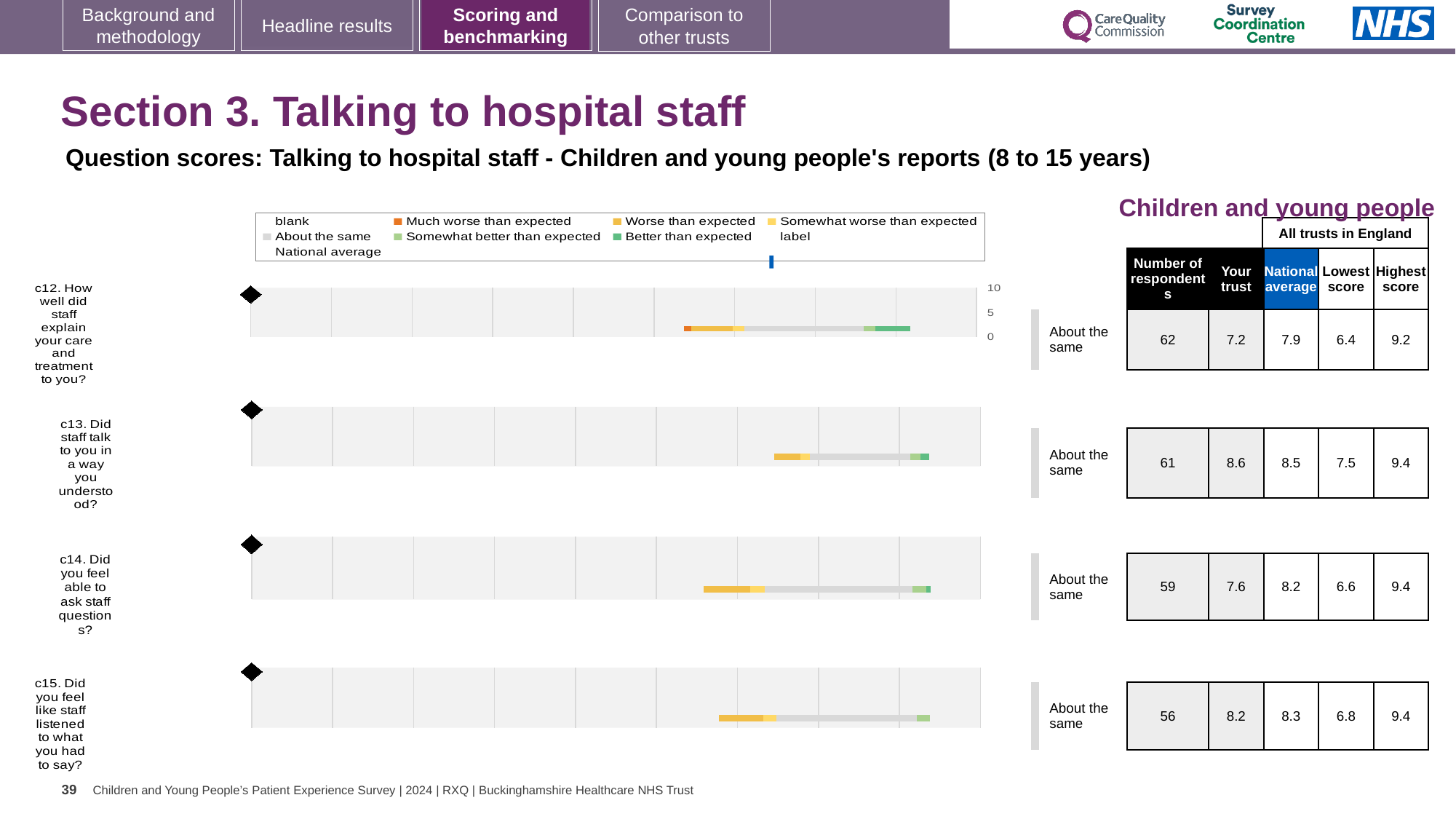
How many questions (c12 to c15) are charted on the slide? 4 What benchmark category is shown for c12? About the same Which question has the lowest 'Your trust' score? c12 For c15, which is larger: the 'Your trust' score or the national average? National average What is the maximum value shown on the chart's score axis? 10 How many respondents answered c15 (Did you feel like staff listened to what you had to say?)? 56 For c14, how much higher is the national average than the 'Your trust' score? 0.6 Which question has the highest 'Your trust' score? c13 What kind of chart is used to show the question scores for c12 to c15? bar chart What is the national average score for c13 (Did staff talk to you in a way you understood?)? 8.5 What is the highest score among all trusts in England for c12? 9.2 What is the 'Your trust' score for c12 (How well did staff explain your care and treatment to you?)? 7.2